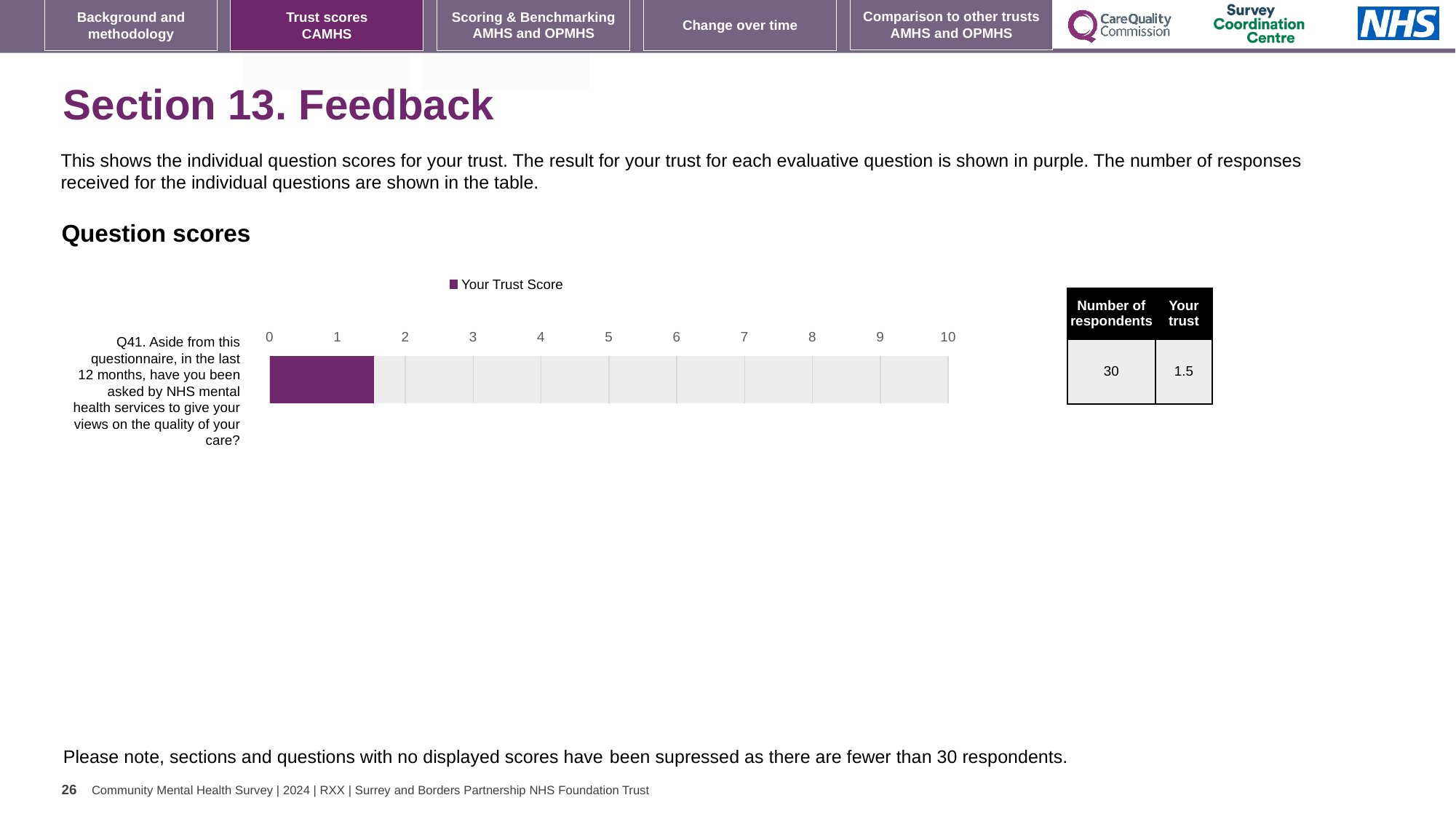
According to the table next to the chart, how many respondents answered Q41? 30 How many questions (categories) are plotted in the chart? 1 According to the table next to the chart, what is the trust score for Q41? 1.5 Is the trust score for Q41 greater or less than 5? less What is the legend entry for the series shown in the chart? Your Trust Score How many series does the chart legend list? 1 What kind of chart is shown under 'Question scores'? bar chart Is the trust score for Q41 greater or less than 1? greater What is the highest value shown on the chart's x axis? 10 Is the trust score for Q41 greater or less than 2? less What colour is the bar representing the trust score in the chart? purple